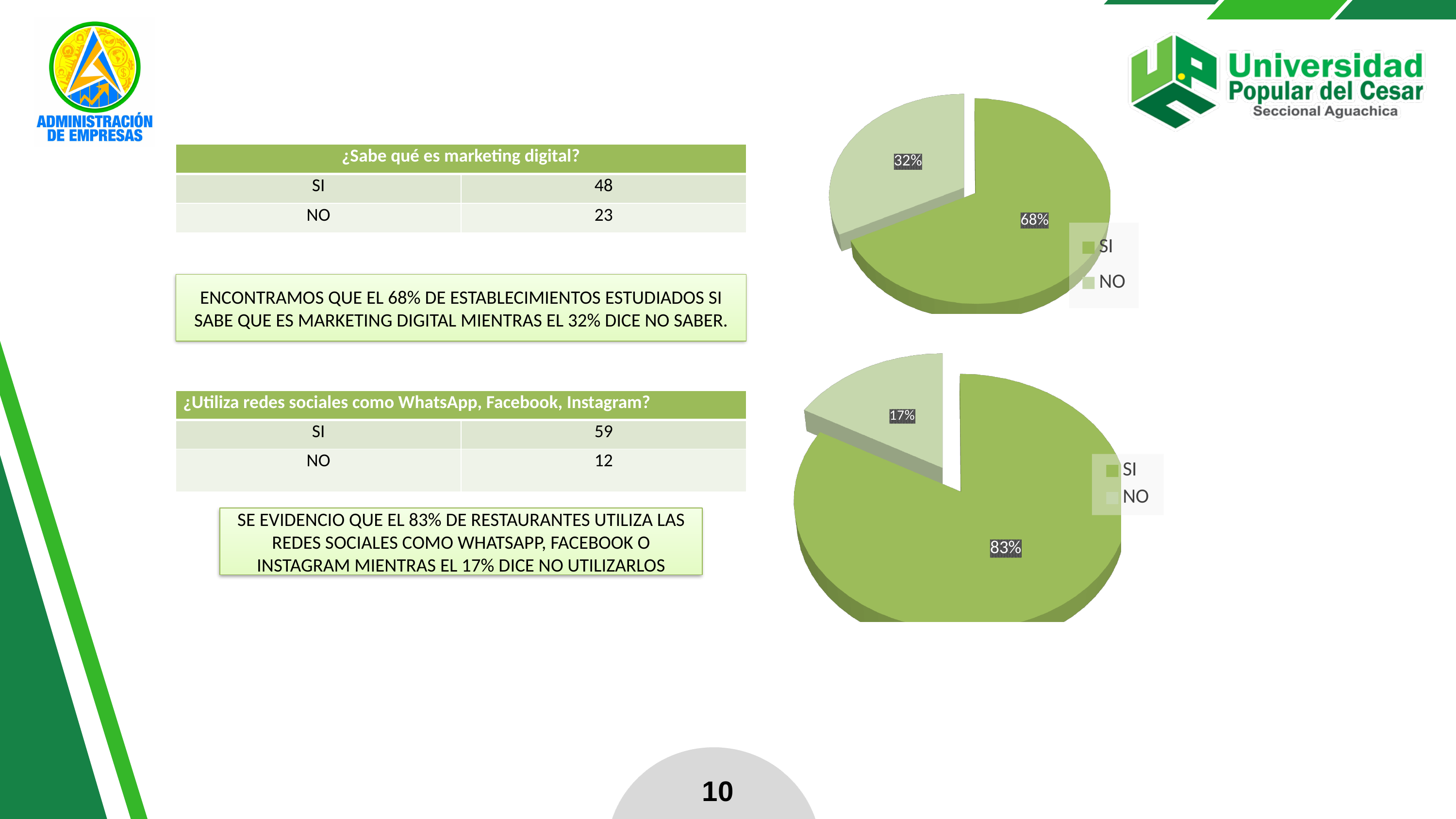
In the bottom pie chart, which slice is larger, SI or NO? SI In the bottom pie chart, which slice is the smallest? NO How many entries does the legend of the top pie chart list? 2 In the top pie chart, what is the difference in percentage points between the SI and NO slices? 36 In the bottom pie chart, what is the difference in percentage points between the SI and NO slices? 66 In the bottom pie chart, what percentage is shown for the SI slice? 83% In the bottom pie chart, what percentage is shown for the NO slice? 17% What type of chart is the top chart on the slide? Pie chart In the top pie chart, what percentage is shown for the NO slice? 32% In the top pie chart, what percentage is shown for the SI slice? 68% In the top pie chart, which slice is the largest? SI How many slices does the bottom pie chart have? 2